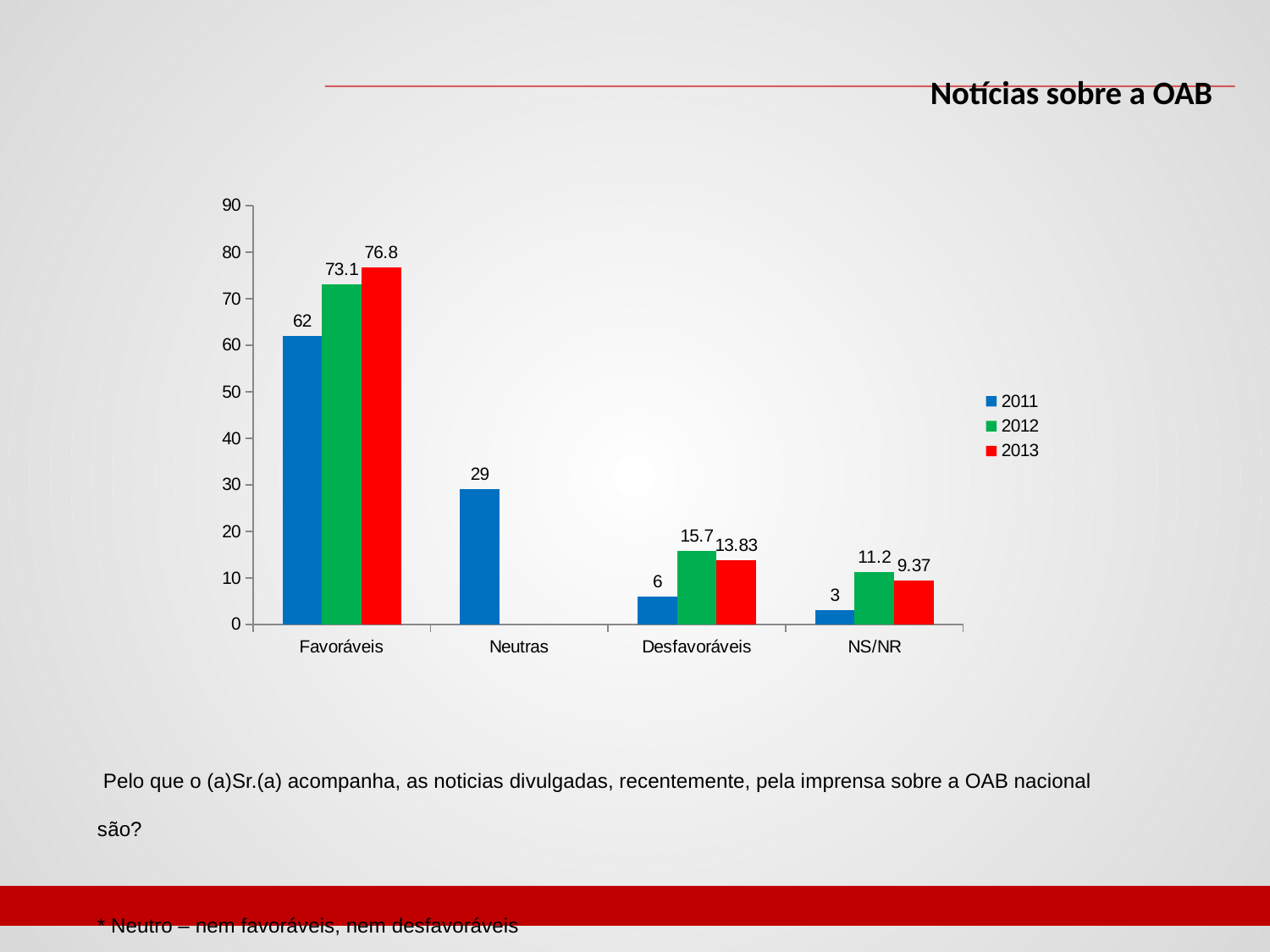
Which colour represents the 2012 series in the legend? Green What is the difference between the 2013 and 2011 values for Favoráveis? 14.8 How many categories are shown on the x axis? 4 What is the value for Favoráveis in 2013? 76.8 What is the value for Desfavoráveis in 2012? 15.7 What kind of chart is shown on the slide? Bar chart What is the value for NS/NR in 2013? 9.37 Which category has the highest value for 2011? Favoráveis Which is larger, the 2012 value for Desfavoráveis or the 2012 value for NS/NR? 2012 value for Desfavoráveis Which category has the lowest value for 2011? NS/NR How many series does the legend list? 3 What is the value for Neutras in 2011? 29